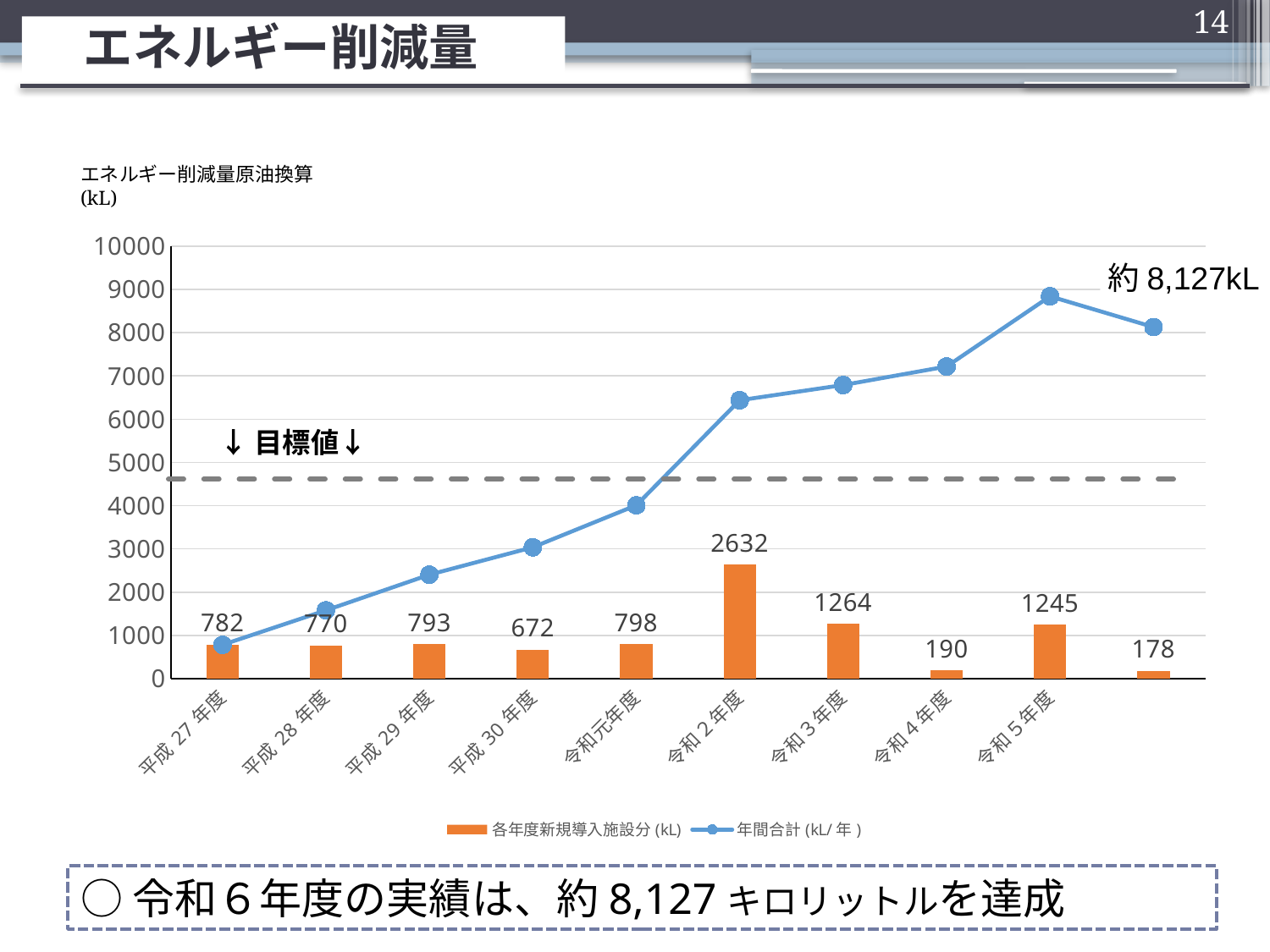
Which year has the highest bar value? 令和2年度 How many series does the legend list? 2 What is the difference between the bar values for 令和2年度 and 令和3年度? 1368 Which bar is larger, 令和3年度 or 令和5年度? 令和3年度 Is the 年間合計 line value for 令和2年度 greater or less than 6000? greater What kind of chart is shown? Combination bar and line chart What is the value of the bar for 令和4年度? 190 Is the 年間合計 line value for 令和5年度 greater or less than 8000? greater What is the value of the bar for 令和2年度? 2632 Does the 年間合計 line rise or fall from 平成27年度 to 令和5年度? Rises What is the value of the bar for 平成30年度? 672 What is the difference between the bar values for 令和3年度 and 令和4年度? 1074